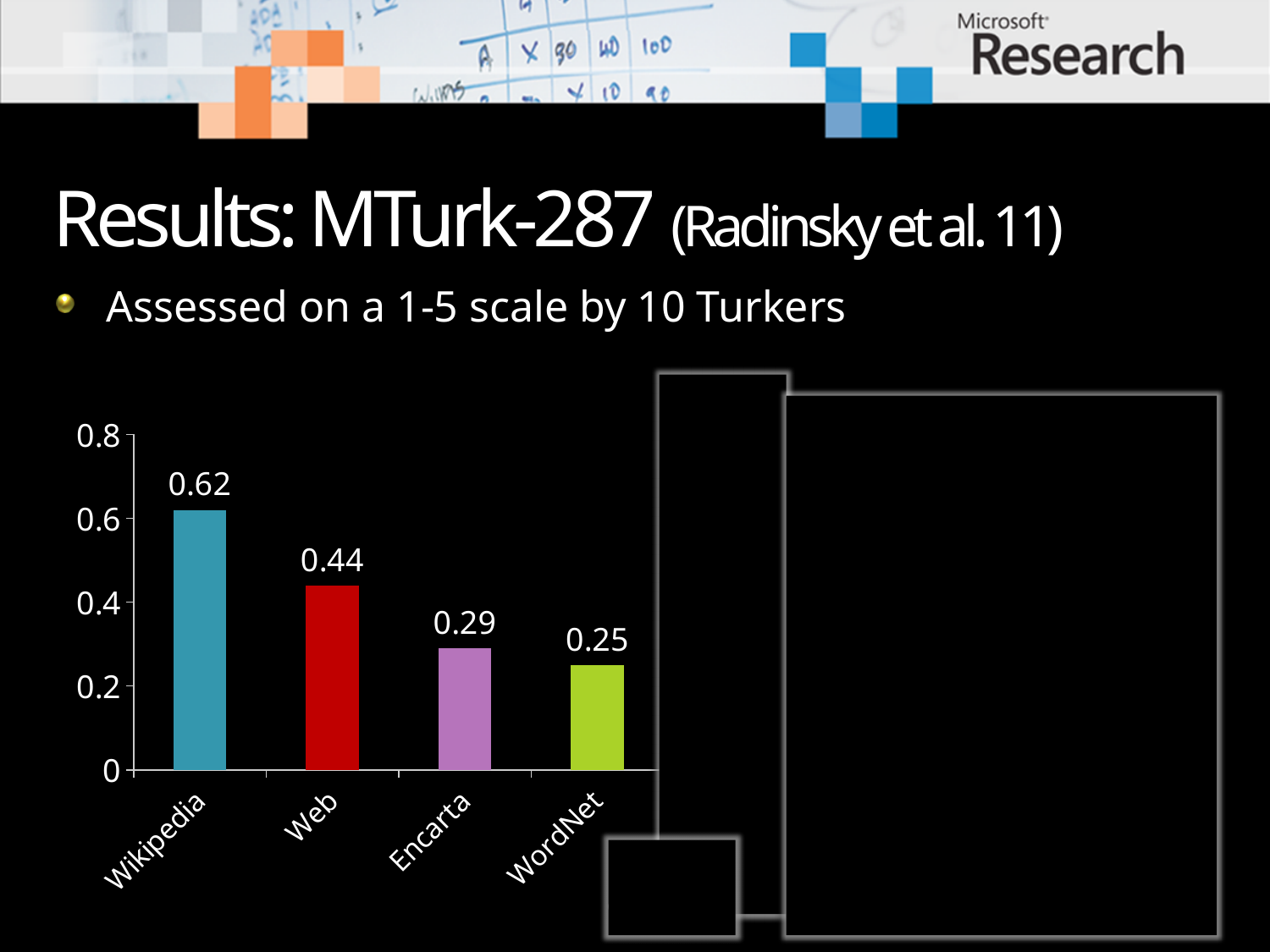
Which category has the lowest value? WordNet Which category has the highest value? Wikipedia What is the value for Wikipedia? 0.62 What is the difference between the values for Wikipedia and Web? 0.18 Which has a larger value, Web or Encarta? Web What is the difference between the values for Encarta and WordNet? 0.04 What is the value for Encarta? 0.29 What is the value for Web? 0.44 What kind of chart is shown on the slide? bar chart What is the value for WordNet? 0.25 Is the value for Wikipedia greater or less than 0.6? greater How many categories are shown on the x axis? 4